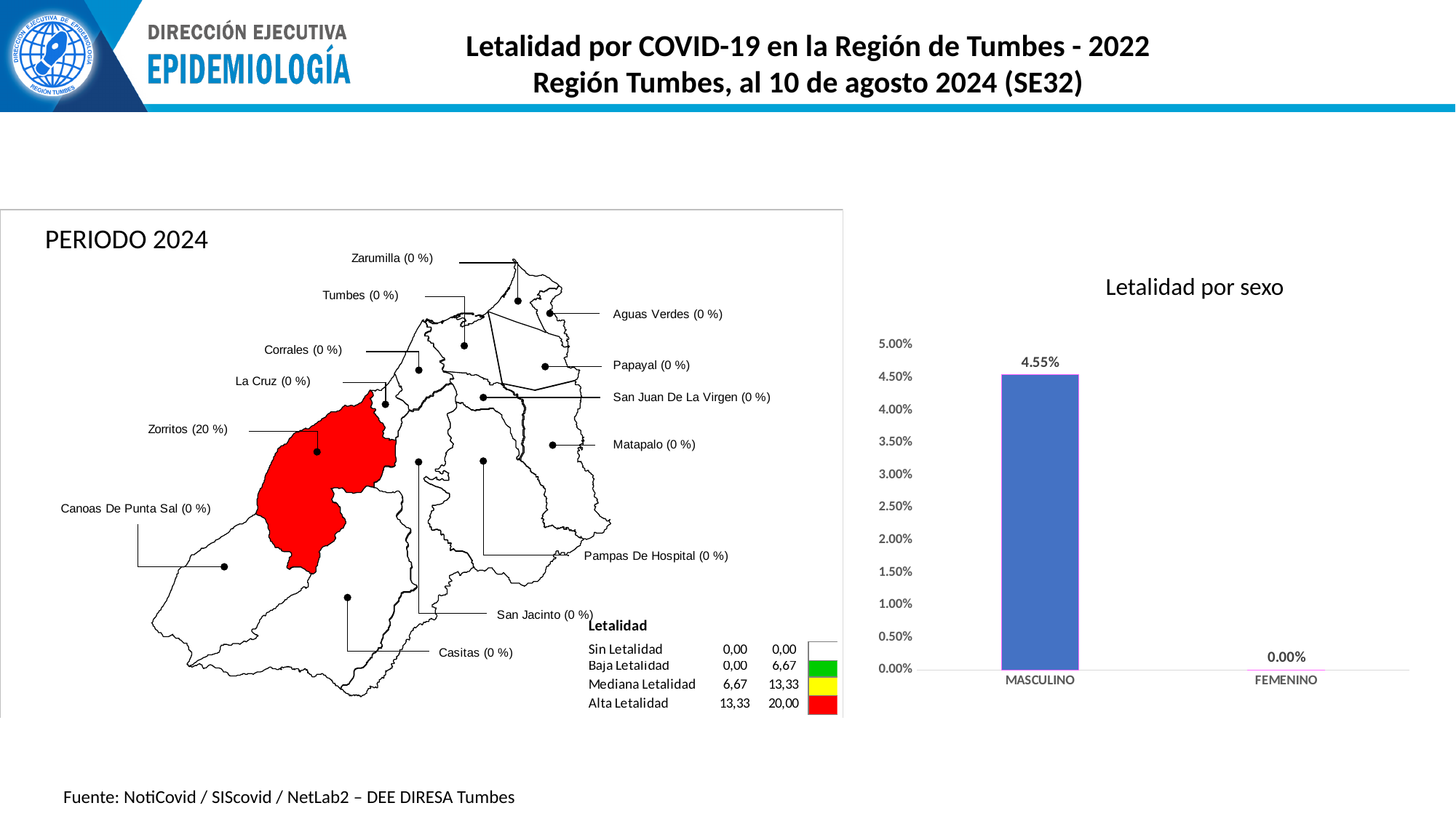
In the 'Letalidad por sexo' chart, what is the value for FEMENINO? 0.00% On the map labelled 'PERIODO 2024', which district is labelled with a lethality of 20 %? Zorritos In the 'Letalidad por sexo' chart, what is the difference between the MASCULINO and FEMENINO values? 4.55% What is the highest tick value shown on the y axis of the 'Letalidad por sexo' chart? 5.00% In the 'Letalidad por sexo' chart, what is the value for MASCULINO? 4.55% In the 'Letalidad por sexo' chart, which category has the highest value? MASCULINO What kind of chart is the 'Letalidad por sexo' chart? bar chart What is the title of the chart on the right side of the slide? Letalidad por sexo In the 'Letalidad por sexo' chart, which is larger, MASCULINO or FEMENINO? MASCULINO In the 'Letalidad por sexo' chart, which category has the lowest value? FEMENINO In the 'Letalidad por sexo' chart, is the value for MASCULINO greater or less than 4.00%? greater How many categories are shown on the x axis of the 'Letalidad por sexo' chart? 2